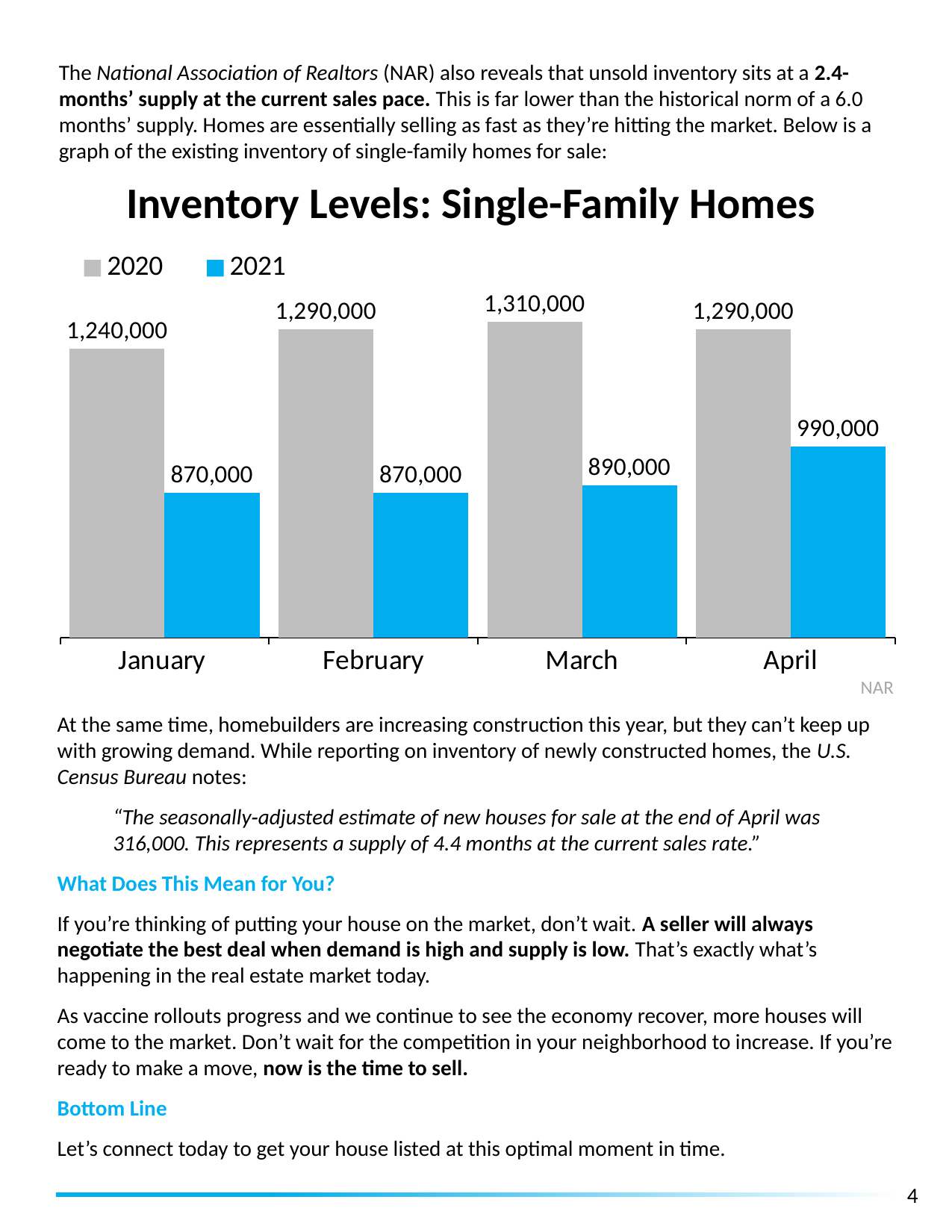
Which month has the highest 2021 inventory level? April What is the 2021 inventory level for January? 870,000 What is the 2020 inventory level for March? 1,310,000 What is the difference between the 2021 inventory levels for April and January? 120,000 What is the 2021 inventory level for April? 990,000 Which is larger, the 2021 inventory level for March or for February? March Which month has the highest 2020 inventory level? March Which month has the lowest 2020 inventory level? January How many months are shown on the x axis? 4 What type of chart is shown? Bar chart How many series does the legend list? 2 What is the difference between the 2020 and 2021 inventory levels for March? 420,000